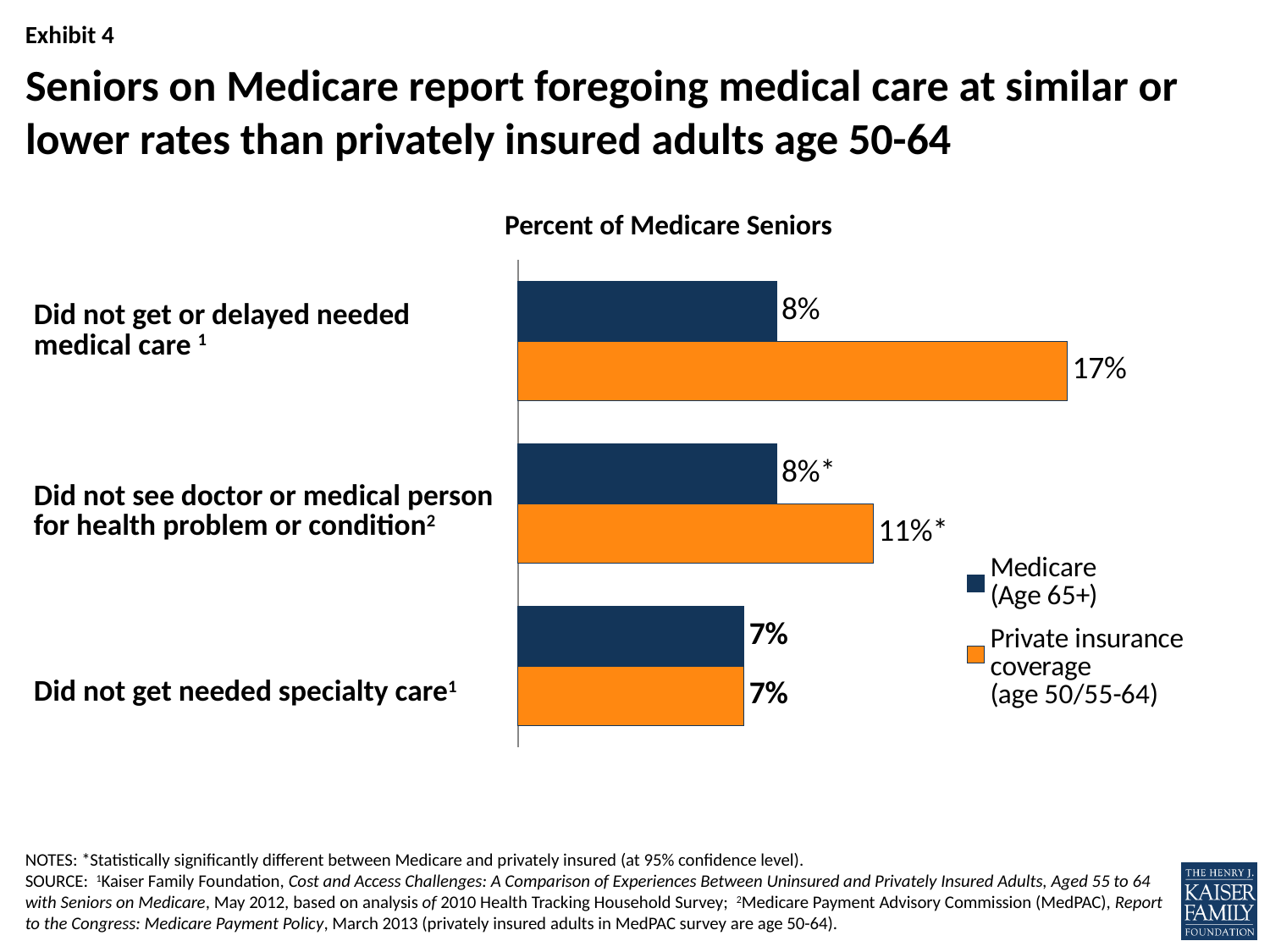
What is the difference between the Private insurance coverage and Medicare values for "Did not get or delayed needed medical care"? 9% What kind of chart is shown on the slide? Bar chart What is the value for Private insurance coverage for "Did not get or delayed needed medical care"? 17% What is the value for Medicare (Age 65+) for "Did not get or delayed needed medical care"? 8% For "Did not see doctor or medical person for health problem or condition", which series has the larger value, Medicare (Age 65+) or Private insurance coverage? Private insurance coverage Which category has the highest value for Private insurance coverage? Did not get or delayed needed medical care What is the value for Medicare (Age 65+) for "Did not get needed specialty care"? 7% What is the value for Private insurance coverage for "Did not see doctor or medical person for health problem or condition"? 11%* How many categories are shown on the chart? 3 Which category has the lowest value for Medicare (Age 65+)? Did not get needed specialty care How many series does the legend list? 2 What colour are the bars for Private insurance coverage? Orange